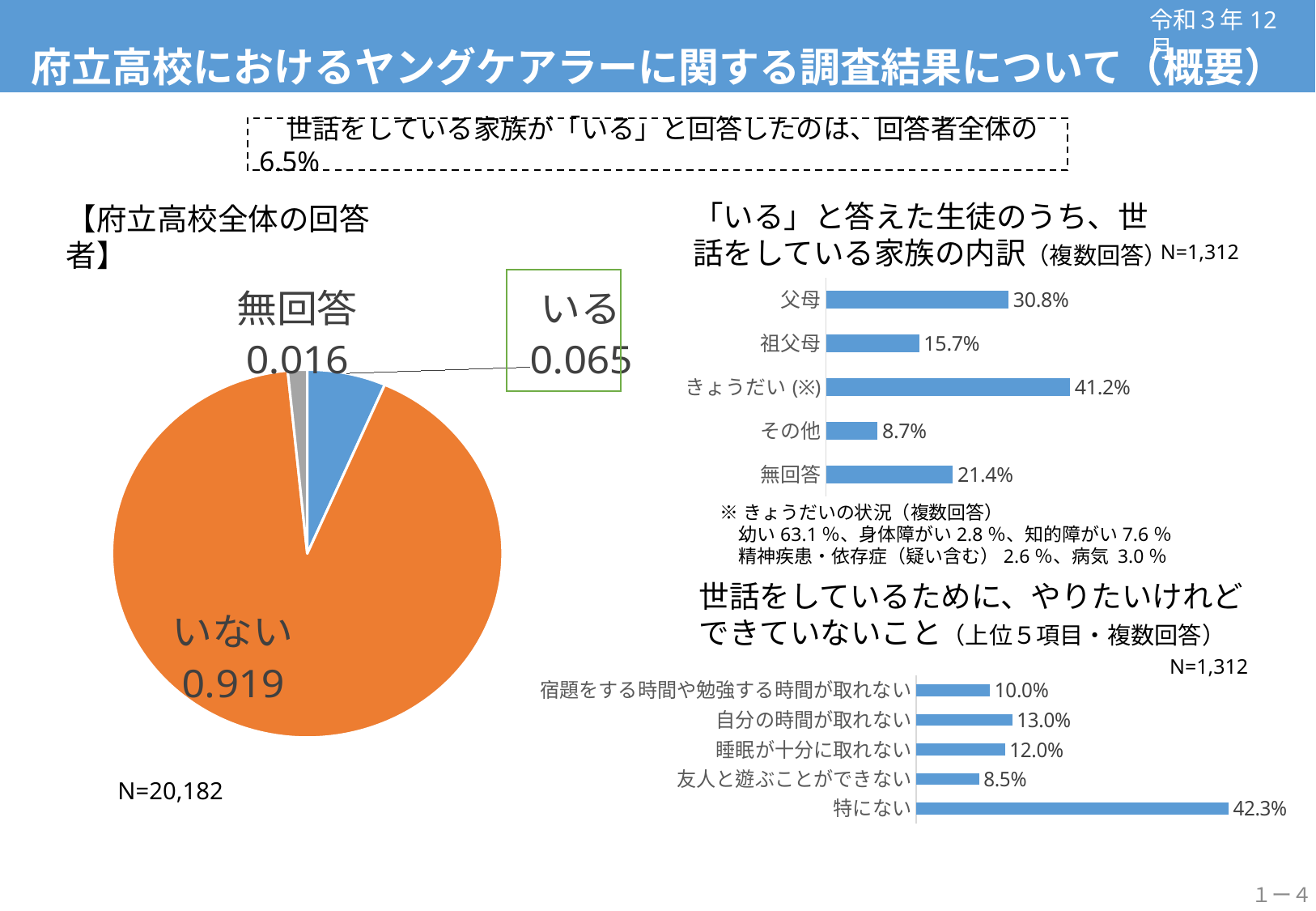
How many categories are shown in the top-right bar chart (世話をしている家族の内訳)? 5 In the top-right bar chart (世話をしている家族の内訳), what is the value for 祖父母? 15.7% In the pie chart on the left, what value is shown for いる? 0.065 In the pie chart on the left (府立高校全体の回答者), what share is labelled for いない? 0.919 In the bottom-right bar chart (やりたいけれどできていないこと), which category has the highest value? 特にない In the pie chart on the left, which slice is the smallest? 無回答 What type of chart is the chart on the left of the slide? pie chart In the top-right bar chart (世話をしている家族の内訳), which category has the lowest value? その他 In the bottom-right bar chart (やりたいけれどできていないこと), which is larger: 自分の時間が取れない or 友人と遊ぶことができない? 自分の時間が取れない In the top-right bar chart (世話をしている家族の内訳), what is the difference between 父母 and 祖父母? 15.1% In the bottom-right bar chart (やりたいけれどできていないこと), what is the value for 睡眠が十分に取れない? 12.0% In the top-right bar chart (世話をしている家族の内訳), which category has the highest value? きょうだい (※)